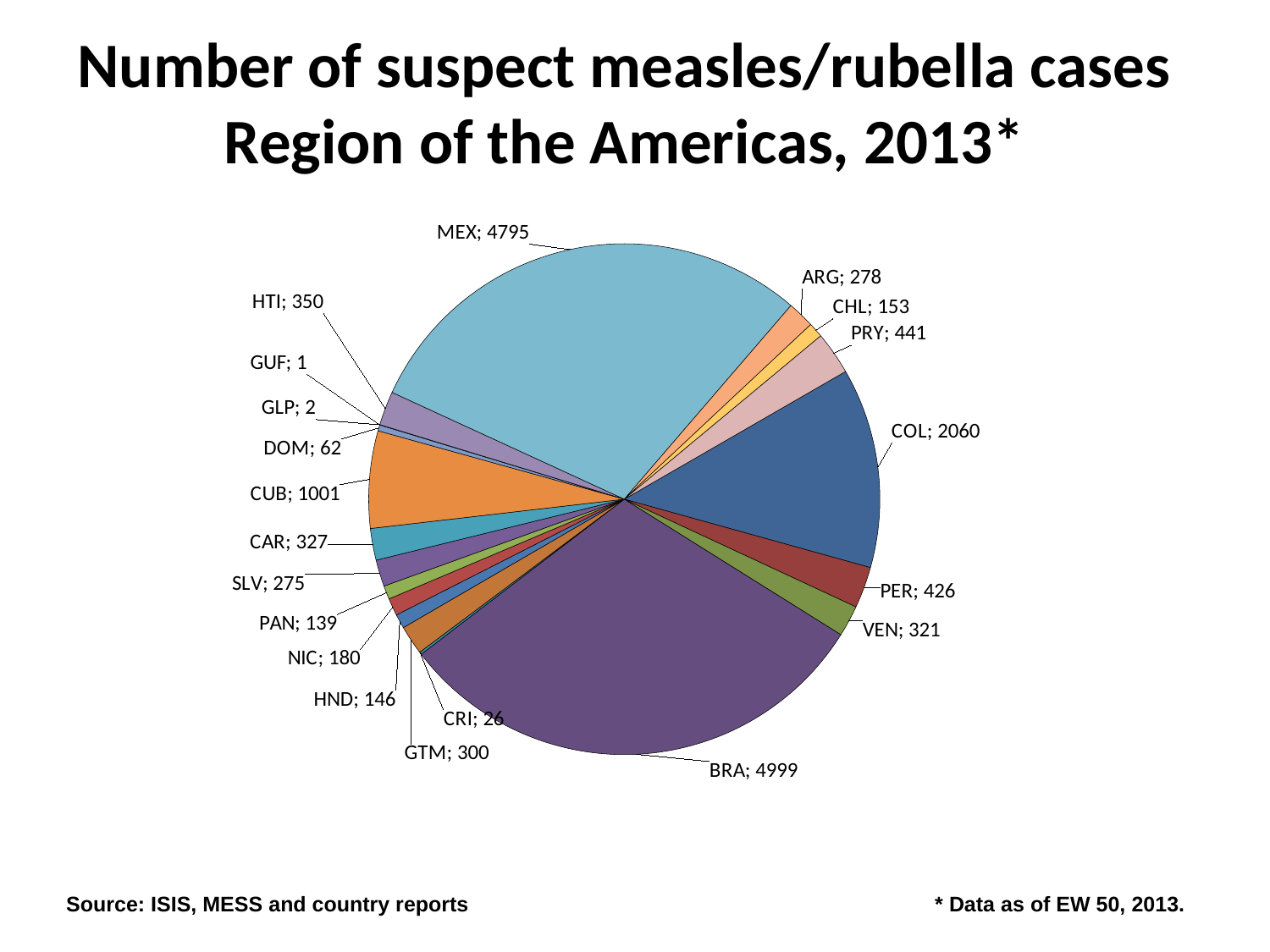
What is the value shown for HTI? 350 What is the title of the chart? Number of suspect measles/rubella cases Region of the Americas, 2013* Which is larger, the value for PRY or the value for PER? PRY Which country has the smallest number of suspect cases? GUF What is the difference between the values for BRA and MEX? 204 What is the value shown for COL? 2060 What is the difference between the values for COL and CUB? 1059 What kind of chart is shown on the slide? pie chart What is the value shown for CUB? 1001 How many suspect measles/rubella cases are shown for MEX? 4795 How many countries or territories are shown in the pie chart? 20 Which country has the largest number of suspect cases? BRA